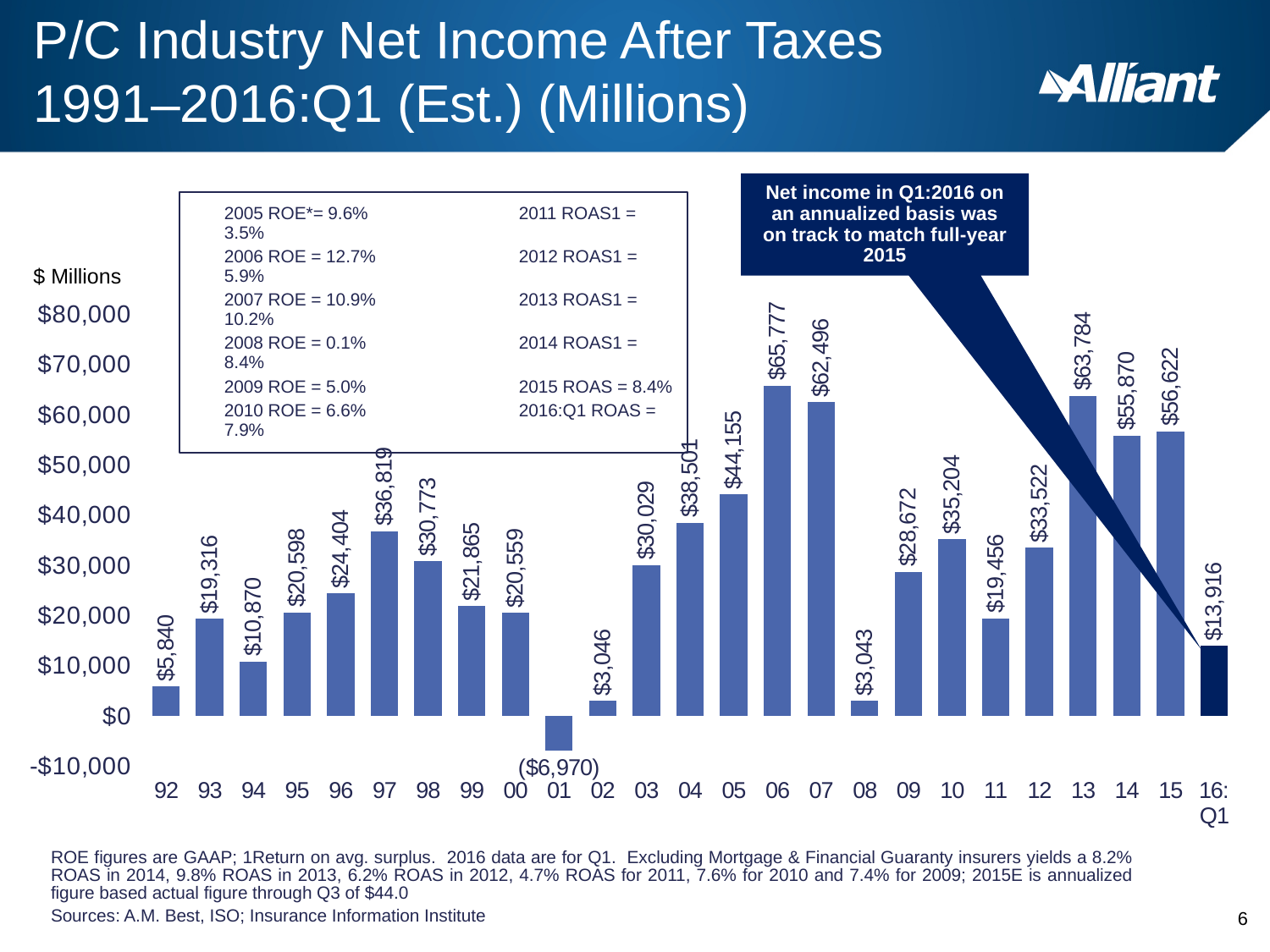
How many bars are plotted on the chart? 25 What is the net income value shown for 2001? ($6,970) Which is larger, the value for 1997 or the value for 1998? 1997 What kind of chart is shown on the slide? Bar chart What is the net income value shown for 2006? $65,777 Is the value for 2005 greater or less than $40,000? greater Which year has the lowest net income on the chart? 01 What is the difference between the 2013 and 2012 values? $30,262 Which year has the highest net income on the chart? 06 Do the values rise or fall from 2011 to 2013? Rise What is the difference between the 2006 and 2007 values? $3,281 What is the value shown for 16:Q1? $13,916